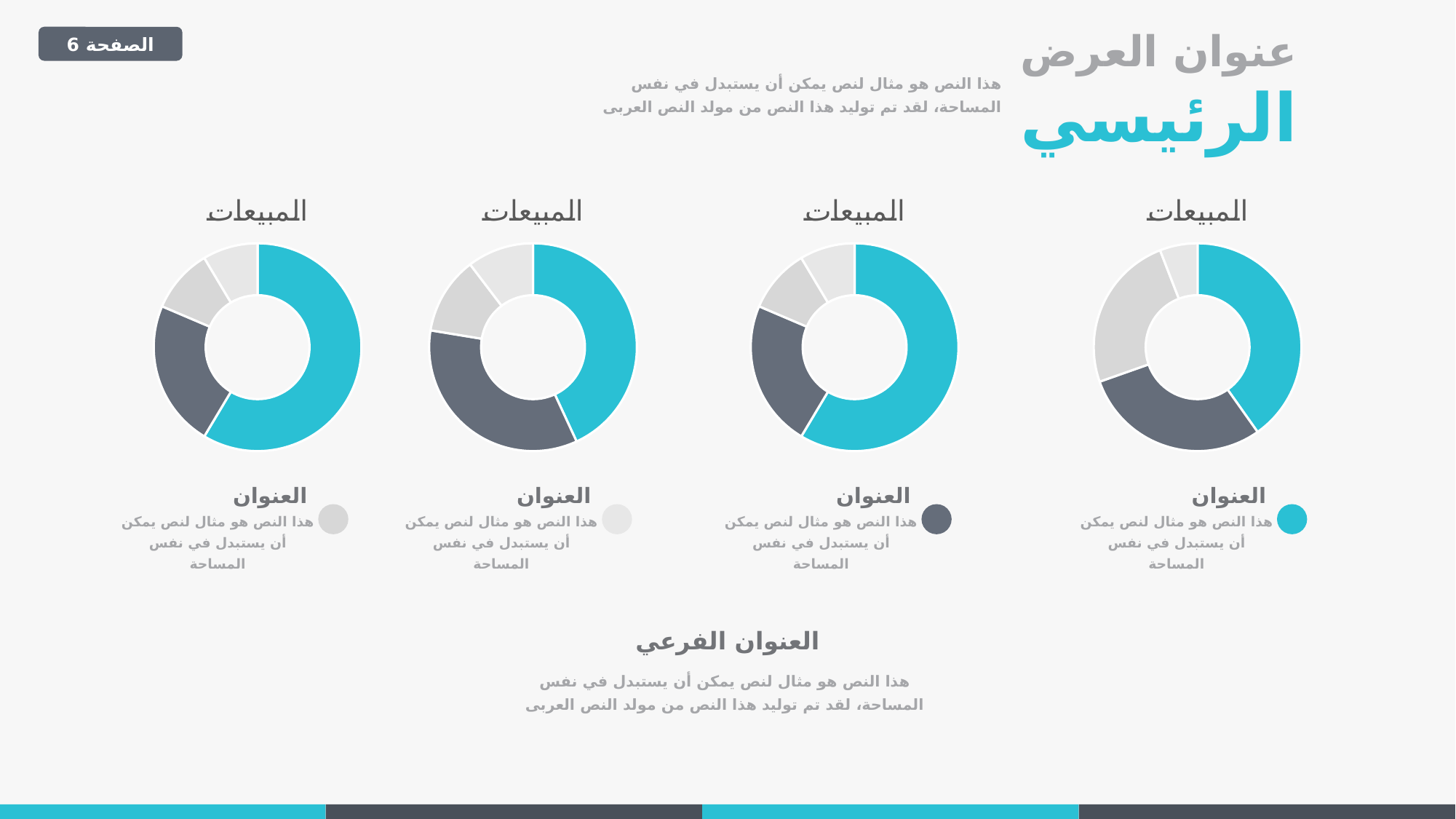
What is the title of the leftmost chart? المبيعات How many doughnut charts are shown on the slide? 4 In the rightmost chart, which is larger, the teal slice or the light gray slice? teal Do all four charts on the slide share the same title? yes In the second chart from the right, which is larger, the dark gray slice or the light gray slice? dark gray In the rightmost chart, which colour slice is the largest? teal How many slices does the leftmost chart have? 4 In the second chart from the left, which is larger, the teal slice or the dark gray slice? teal What kind of chart is the rightmost chart on the slide? doughnut chart In the leftmost chart, which colour slice is the largest? teal How many slices does the rightmost chart have? 4